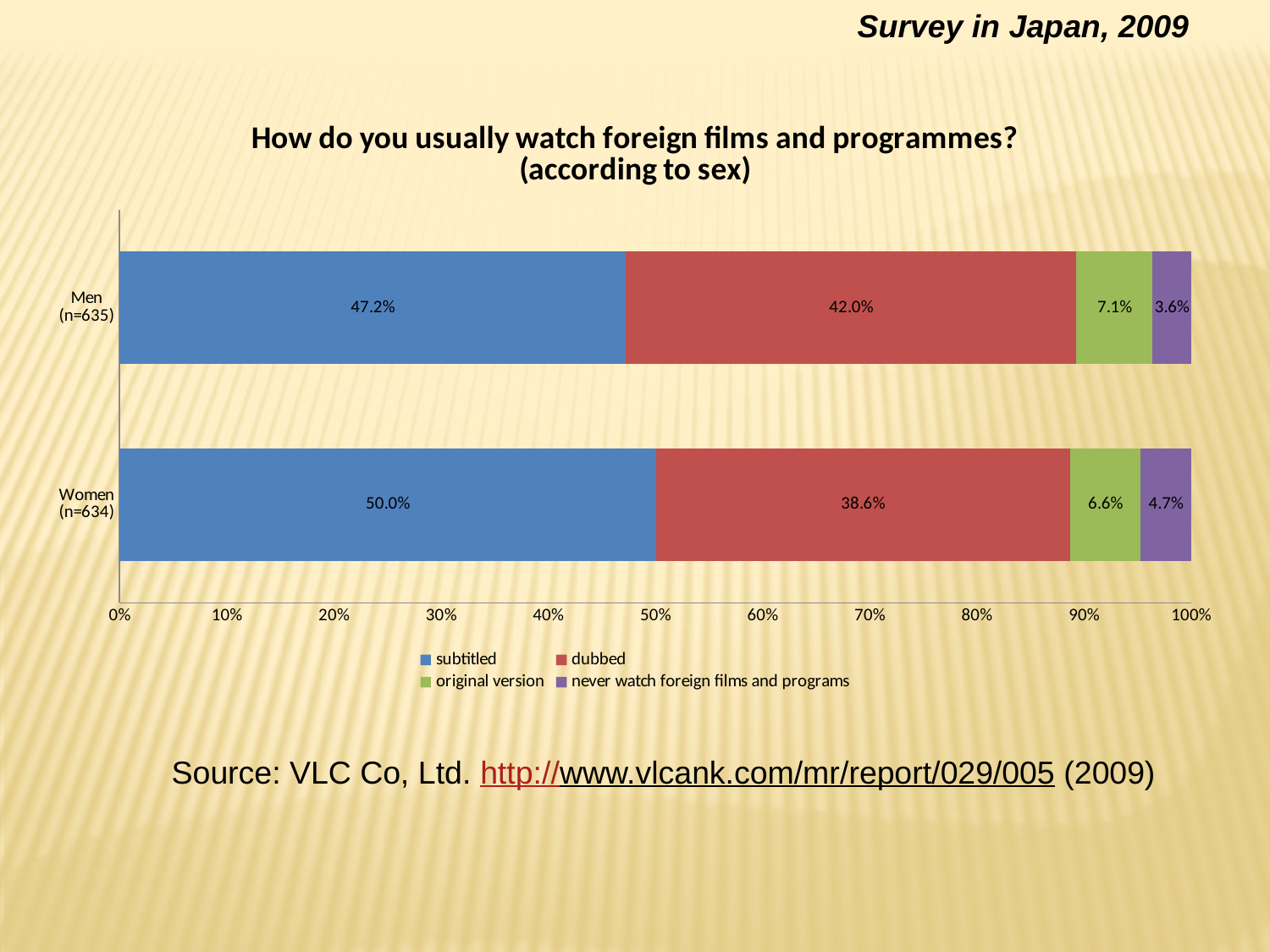
What is the sample size for men shown in the chart? n=635 What is the difference in percentage points between the subtitled share for women and for men? 2.8 percentage points What percentage of men usually watch foreign films and programmes subtitled? 47.2% Which viewing option has the lowest share among men? never watch foreign films and programs What is the value for 'original version' among men? 7.1% Which group has a larger share for 'dubbed', men or women? Men What percentage of women never watch foreign films and programs? 4.7% What percentage of women usually watch foreign films and programmes dubbed? 38.6% How many series does the legend list? 4 What kind of chart is shown on the slide? Stacked bar chart Which viewing option has the highest share among women? subtitled How many groups (bars) are shown in the chart? 2